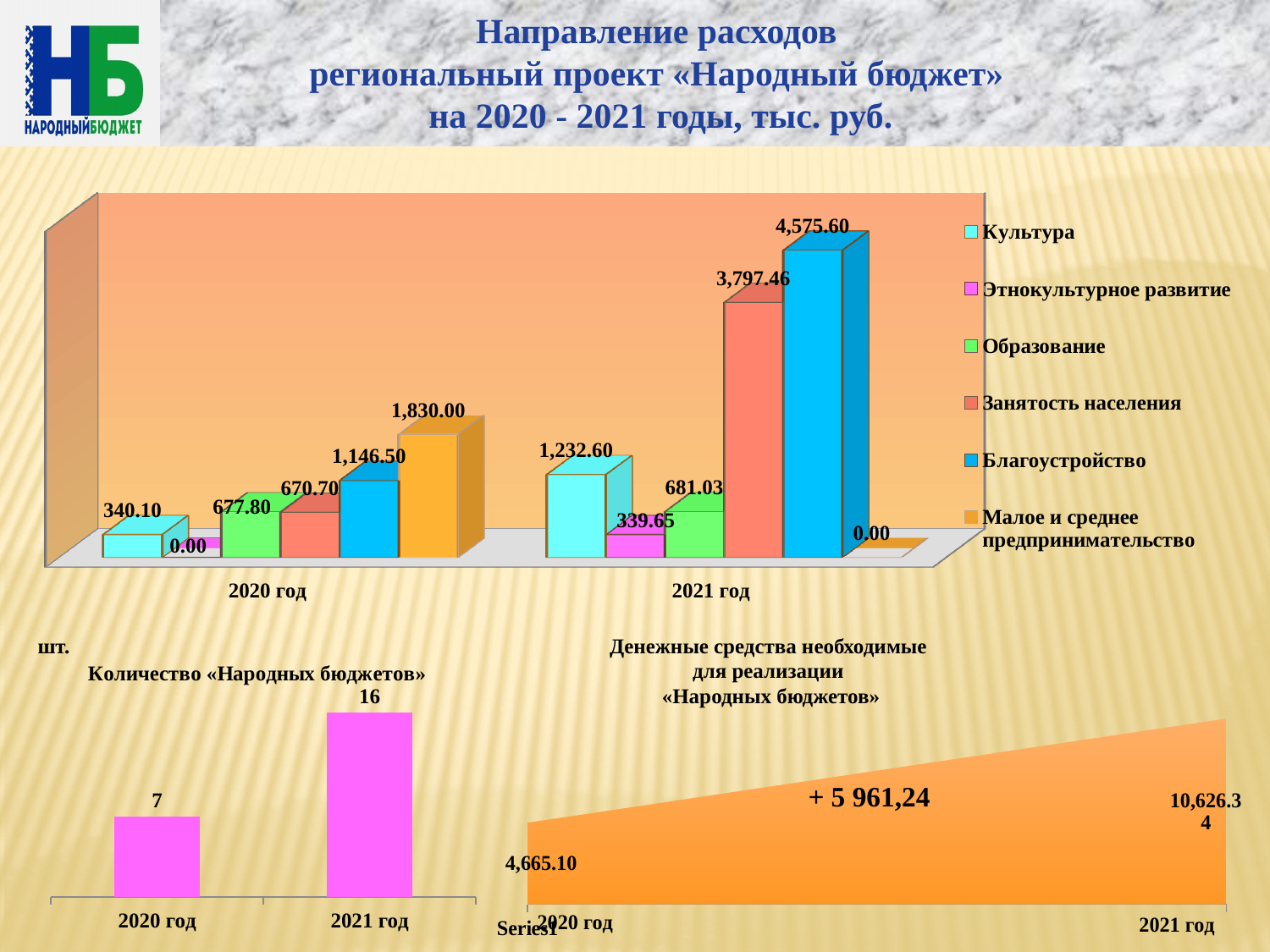
In the chart titled «Количество «Народных бюджетов»», what is the value for 2021 год? 16 How many series does the legend of the top chart list? 6 In the top chart, which is larger in 2020 год: Образование or Занятость населения? Образование In the top chart, what is the value for Благоустройство in 2021 год? 4,575.60 In the top chart, what is the value for Культура in 2021 год? 1,232.60 In the bottom-right chart «Денежные средства необходимые для реализации «Народных бюджетов»», what is the value for 2020 год? 4,665.10 In the top chart, what is the difference between Занятость населения in 2021 год and in 2020 год? 3,126.76 In the chart titled «Количество «Народных бюджетов»», what is the difference between 2021 год and 2020 год? 9 In the top chart, which series has the highest value in 2021 год? Благоустройство In the top chart, what is the value for Малое и среднее предпринимательство in 2020 год? 1,830.00 In the bottom-right chart «Денежные средства необходимые для реализации «Народных бюджетов»», do the values rise or fall from 2020 год to 2021 год? rise In the top chart, which series has the highest value in 2020 год? Малое и среднее предпринимательство